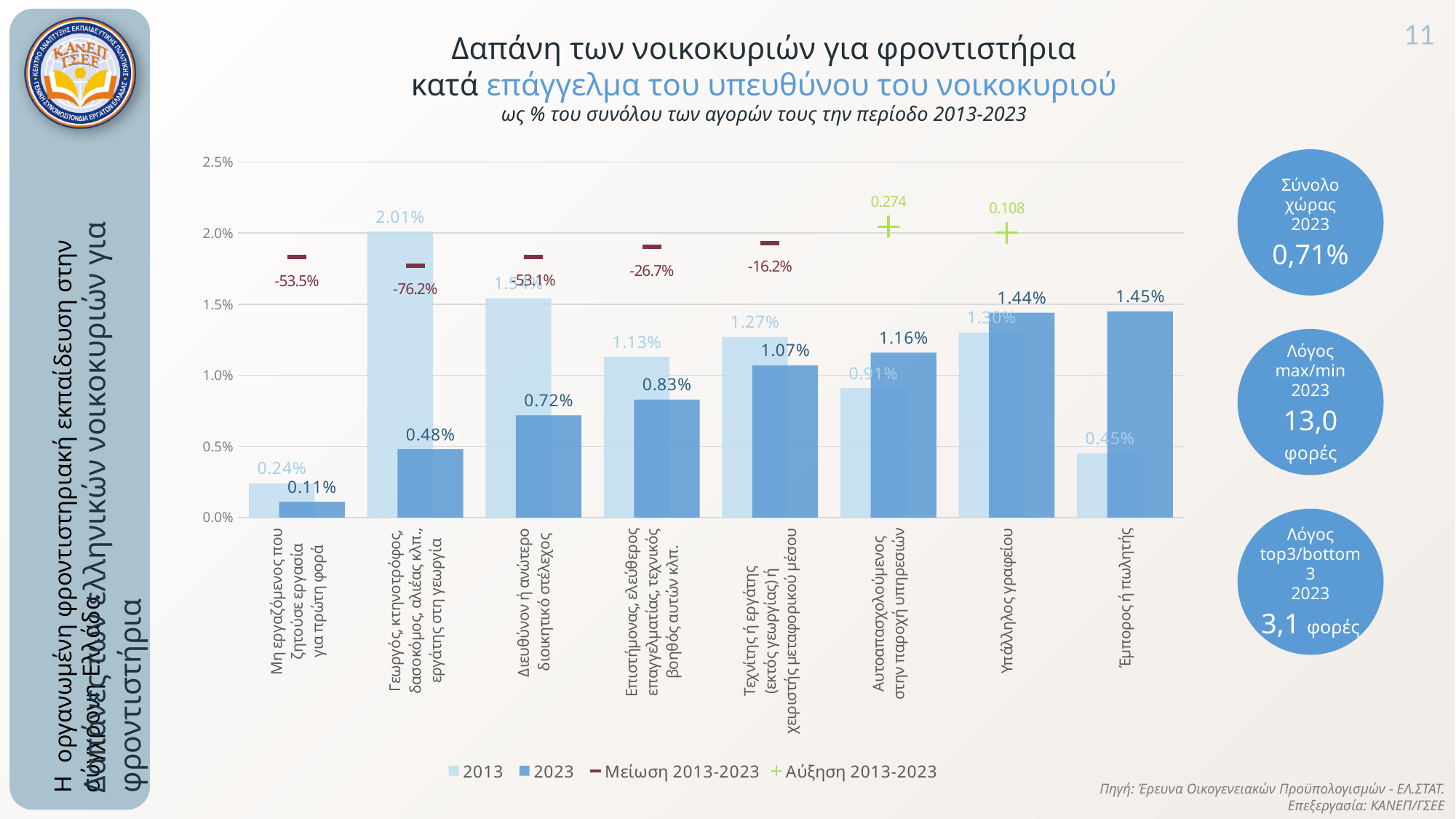
Which category has the lowest 2023 value? Μη εργαζόμενος που ζητούσε εργασία για πρώτη φορά What is the 2023 value for Μη εργαζόμενος που ζητούσε εργασία για πρώτη φορά? 0.11% What percentage change from 2013 to 2023 is shown for Επιστήμονας, ελεύθερος επαγγελματίας, τεχνικός βοηθός αυτών κλπ.? -26.7% What is the difference between the 2013 and 2023 values for Έμπορος ή πωλητής? 1.00 percentage points What is the 2023 value for Έμπορος ή πωλητής? 1.45% How many entries does the legend list? 4 For Υπάλληλος γραφείου, which is larger: the 2013 value or the 2023 value? 2023 What is the 2013 value for Γεωργός, κτηνοτρόφος, δασοκόμος, αλιέας κλπ., εργάτης στη γεωργία? 2.01% Which category has the highest 2013 value? Γεωργός, κτηνοτρόφος, δασοκόμος, αλιέας κλπ., εργάτης στη γεωργία How many occupation categories are shown on the x axis? 8 What kind of chart is shown on the slide? Bar chart Is the 2013 value for Αυτοαπασχολούμενος στην παροχή υπηρεσιών greater or less than 1.0%? less